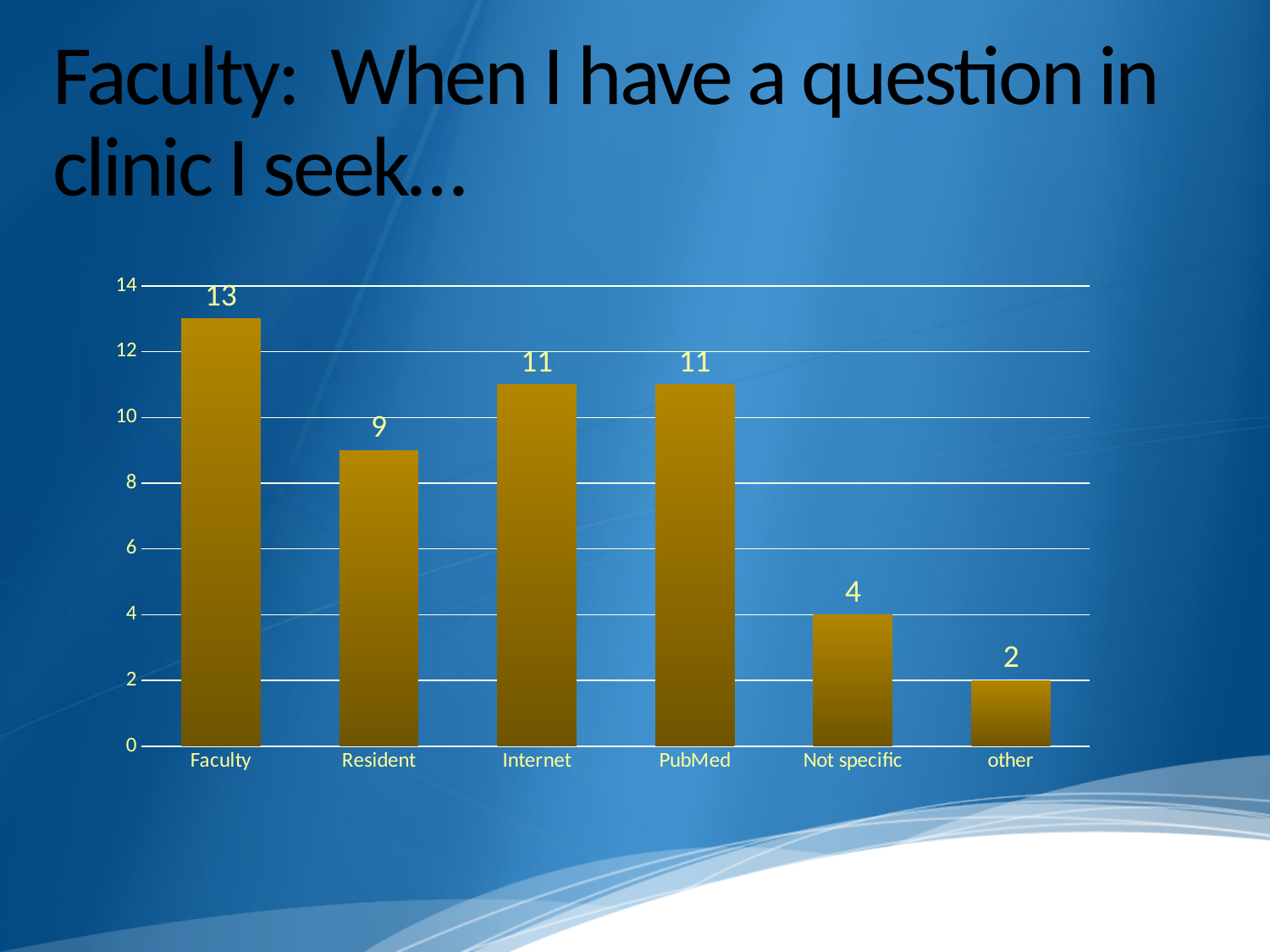
Which category has the highest value? Faculty Which category has the lowest value? other What kind of chart is shown on the slide? bar chart What is the difference between the values for Internet and other? 9 What is the value for Not specific? 4 What is the value for Resident? 9 Which is larger, the value for Resident or the value for PubMed? PubMed What is the value for Faculty? 13 What is the difference between the values for Faculty and Resident? 4 How many categories are shown on the x axis? 6 What is the title of the slide? Faculty: When I have a question in clinic I seek… What is the value for other? 2